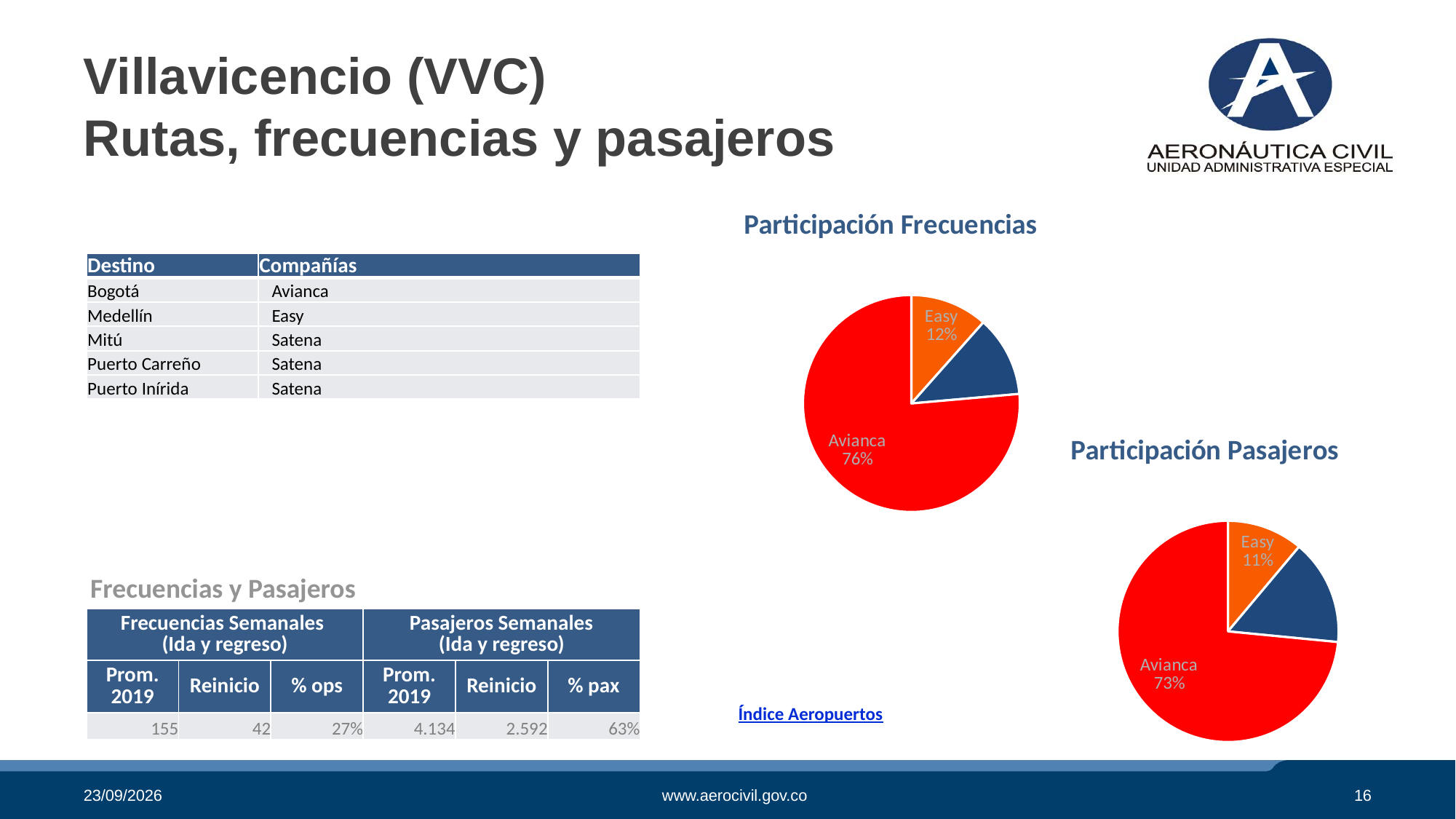
In the Participación Pasajeros chart, what share does Easy have? 11% How many slices does the Participación Frecuencias pie chart have? 3 What type of chart is the Participación Pasajeros chart? Pie chart In the Participación Pasajeros chart, which labelled company has the largest slice? Avianca In the Participación Frecuencias chart, how many percentage points larger is Avianca's share than Easy's? 64 In the Participación Frecuencias chart, what share does Avianca have? 76% Is Avianca's share larger in the Participación Frecuencias chart or in the Participación Pasajeros chart? Participación Frecuencias In the Participación Pasajeros chart, what colour is the Avianca slice? Red In the Participación Pasajeros chart, what share does Avianca have? 73% In the Participación Pasajeros chart, how many percentage points larger is Avianca's share than Easy's? 62 In the Participación Frecuencias chart, which labelled company has the largest slice? Avianca In the Participación Frecuencias chart, what share does Easy have? 12%